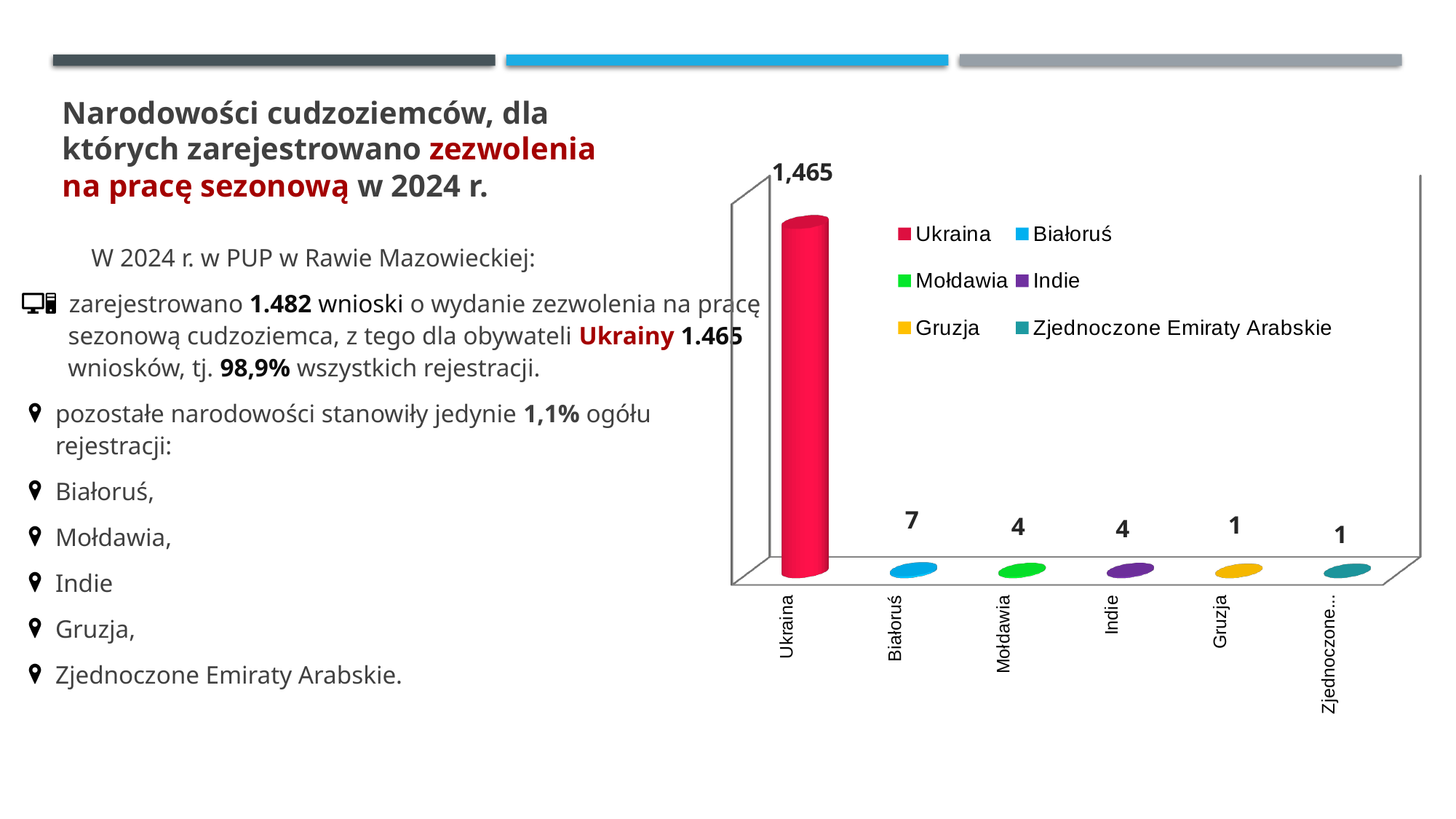
What is the value for Mołdawia in the chart? 4 Which category has the highest value in the chart? Ukraina What is the value for Gruzja in the chart? 1 How many entries does the chart legend list? 6 What is the difference between the values for Ukraina and Białoruś? 1,458 How many categories are shown on the x axis of the chart? 6 What is the value for Ukraina in the chart? 1,465 Which is larger, the value for Białoruś or the value for Mołdawia? Białoruś What kind of chart is shown on the slide? bar chart What colour is the bar for Ukraina in the chart? red What is the difference between the values for Białoruś and Indie? 3 What is the value for Białoruś in the chart? 7